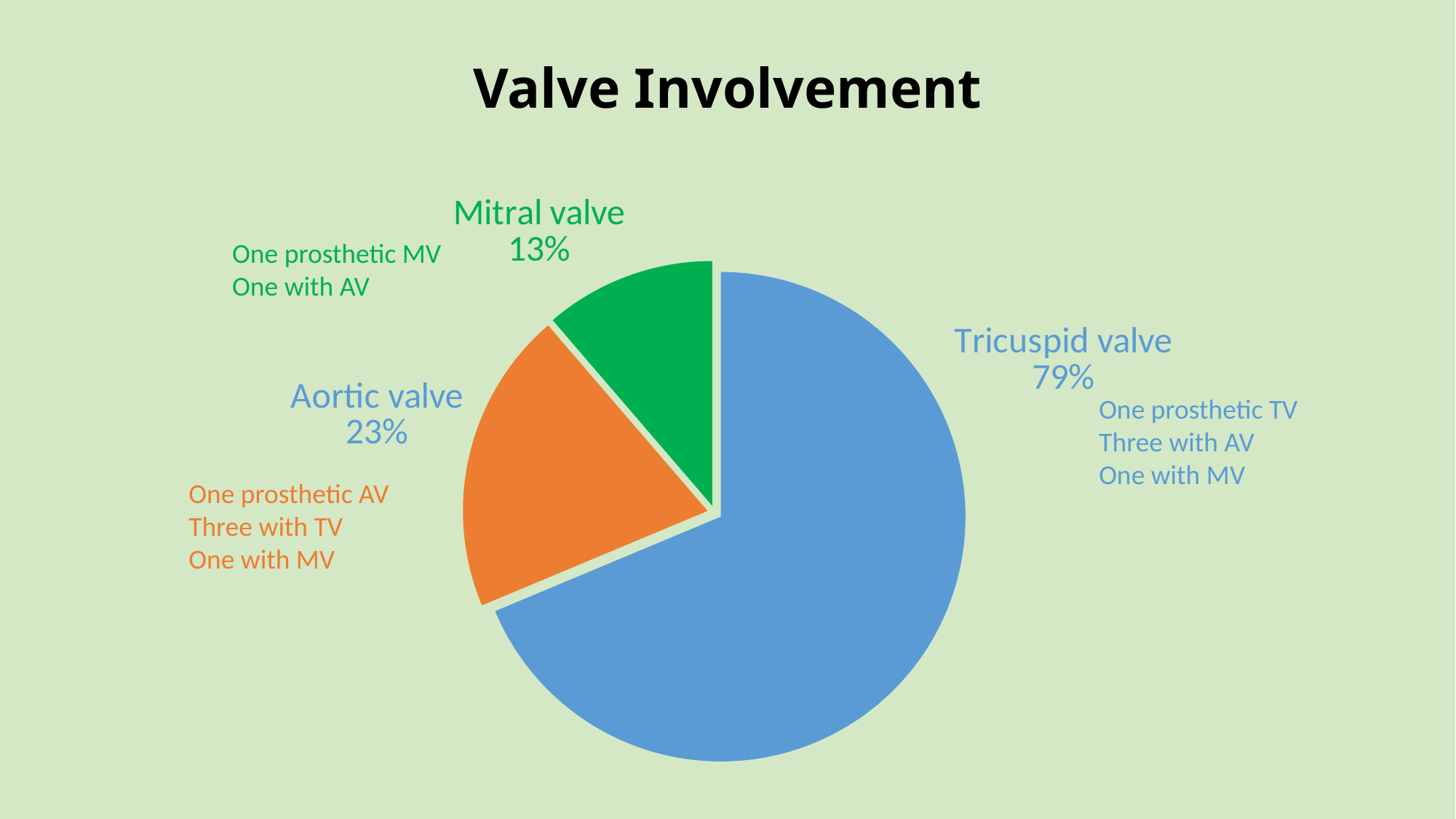
What percentage is shown for Aortic valve? 23% What is the difference in percentage points between Tricuspid valve and Aortic valve? 56 How many slices does the pie chart have? 3 What kind of chart is shown on the slide? Pie chart What is the title of the chart? Valve Involvement What percentage is shown for Tricuspid valve? 79% What is the difference in percentage points between Aortic valve and Mitral valve? 10 What colour is the Tricuspid valve slice? Blue What percentage is shown for Mitral valve? 13% Which is larger, the Aortic valve slice or the Mitral valve slice? Aortic valve Which valve has the smallest slice of the pie? Mitral valve Which valve has the largest slice of the pie? Tricuspid valve